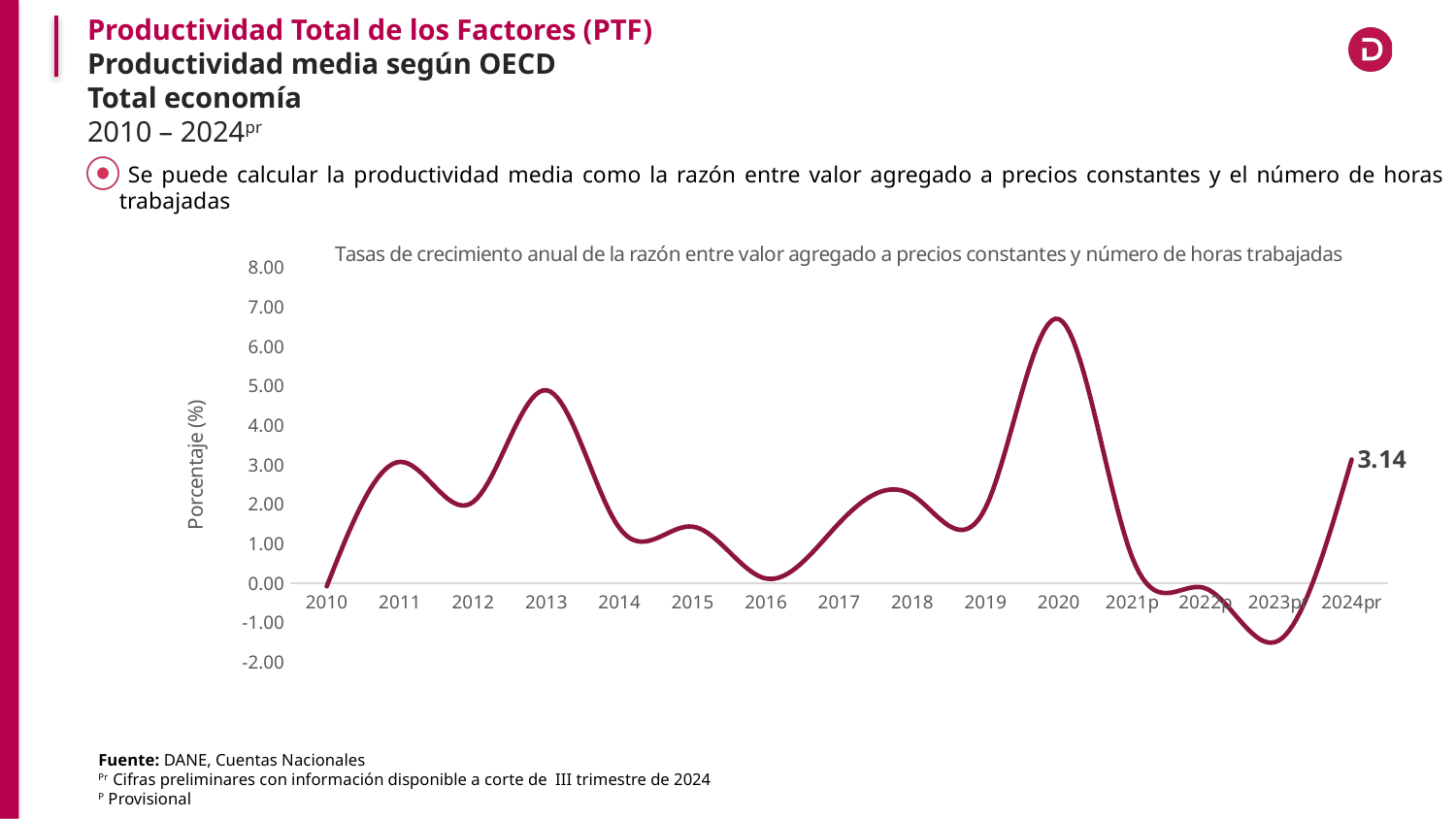
What is the label of the vertical axis of the chart? Porcentaje (%) Is the value for 2016 greater or less than 1.00? less How many years are plotted on the x axis of the chart? 15 Is the value for 2023p greater or less than 0.00? less Do the values rise or fall from 2020 to 2023p? fall Is the value for 2020 greater or less than 6.00? greater What is the value shown for 2024pr on the chart? 3.14 What kind of chart is shown on the slide? line chart Which year has the lowest value on the chart? 2023pr Which year has the highest value on the chart? 2020 Which year has the larger value, 2013 or 2018? 2013